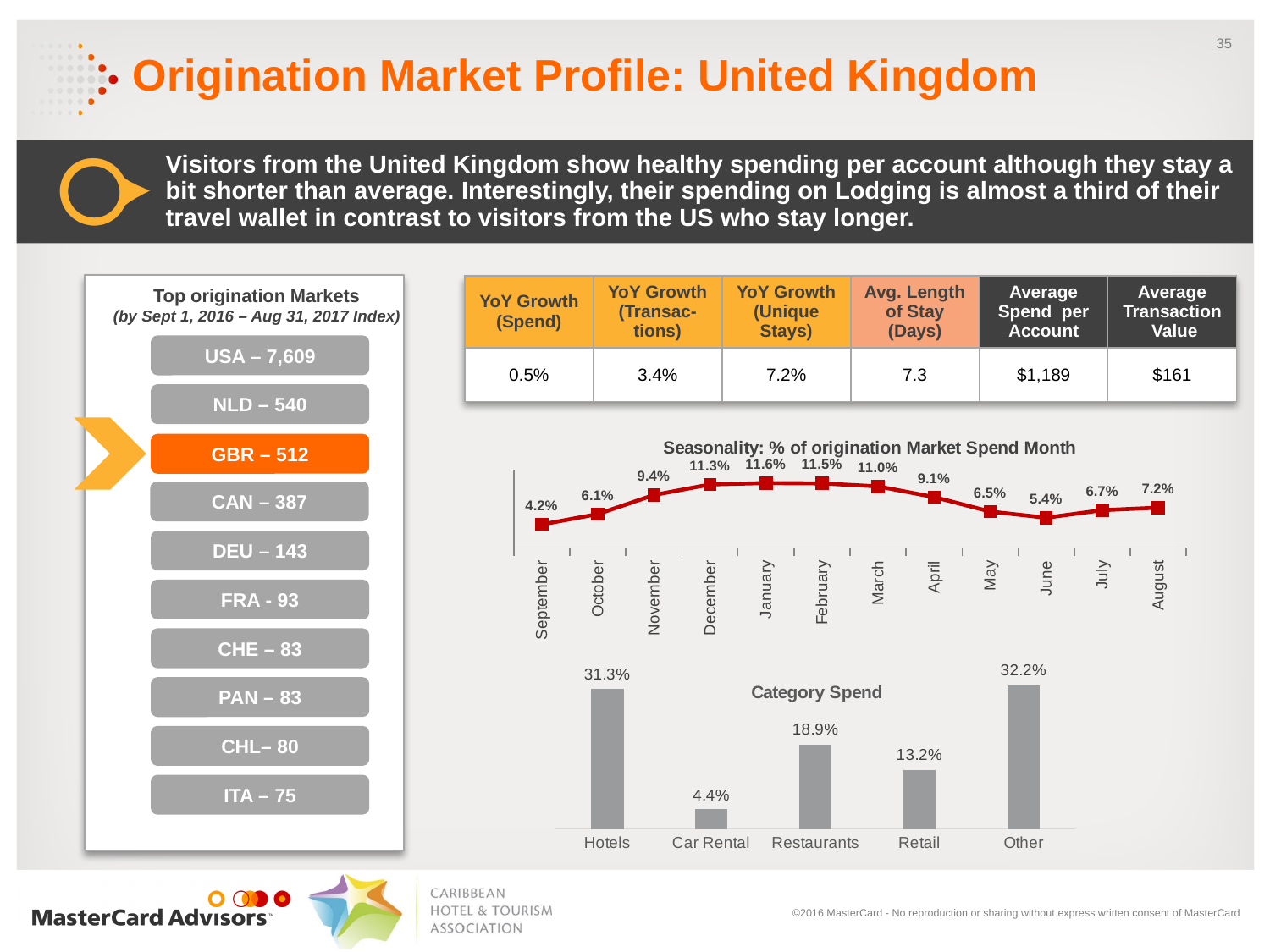
In the Seasonality chart, which month has the lowest value? September In the Seasonality chart, what is the difference between the December and November values? 1.9% In the Seasonality chart, what is the value for January? 11.6% In the Category Spend chart, which category has the lowest value? Car Rental In the Category Spend chart, what is the value for Restaurants? 18.9% In the Category Spend chart, what is the difference between Retail and Car Rental? 8.8% In the Seasonality chart, what is the value for September? 4.2% What kind of chart is the Seasonality chart? line chart In the Category Spend chart, which is larger, Hotels or Other? Other In the Seasonality chart, do the values rise or fall from September to January? rise In the Seasonality chart, which month has the highest value? January In the Seasonality chart, how many months are plotted? 12